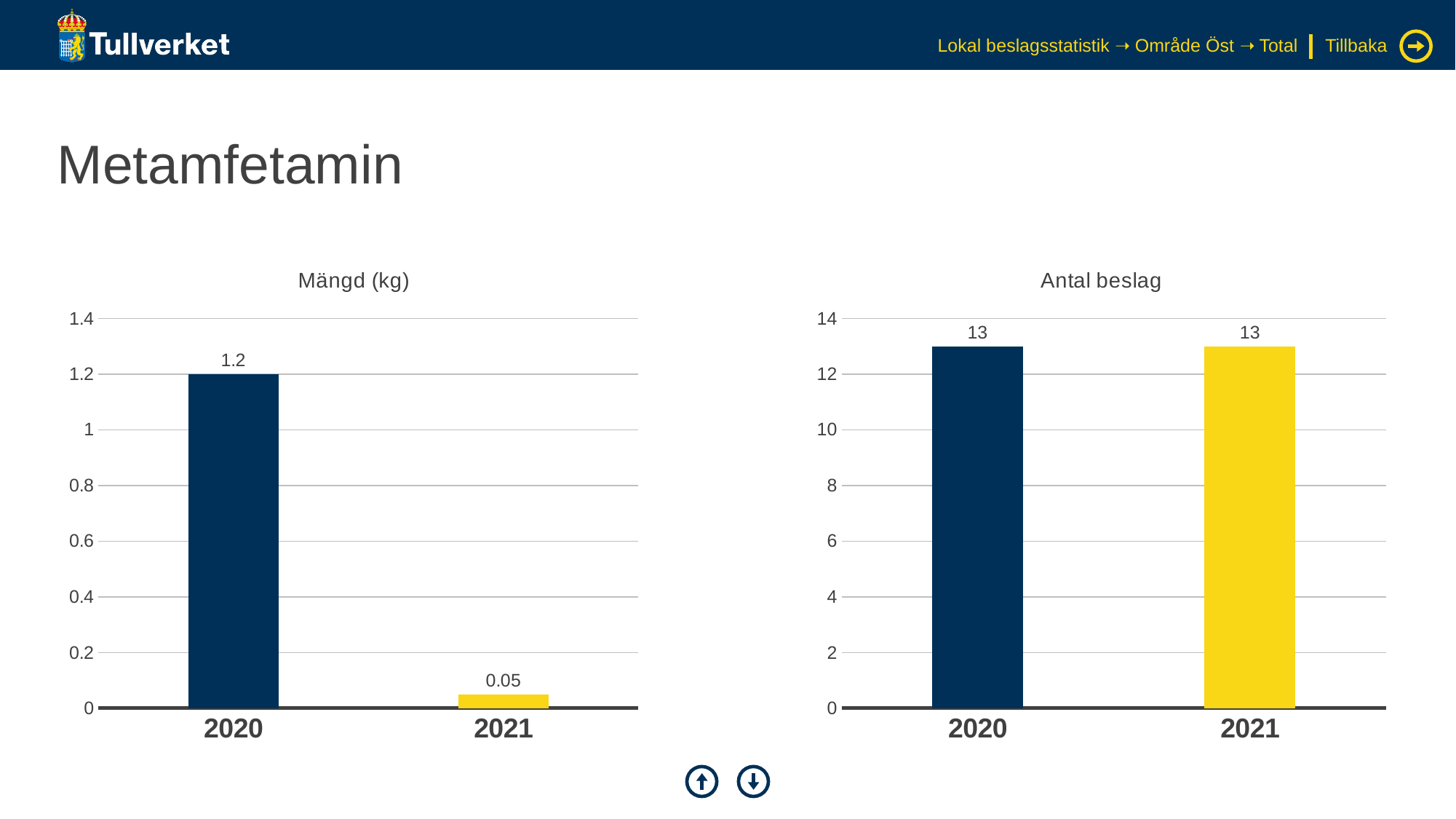
In the 'Mängd (kg)' chart, what is the difference between the 2020 and 2021 values? 1.15 In the 'Mängd (kg)' chart, what is the value for 2020? 1.2 In the 'Mängd (kg)' chart, which year has the lowest value? 2021 In the 'Antal beslag' chart, what is the difference between the 2020 and 2021 values? 0 In the 'Mängd (kg)' chart, is the value for 2020 greater or less than 1? greater In the 'Antal beslag' chart, what is the value for 2021? 13 In the 'Mängd (kg)' chart, do the values rise or fall from 2020 to 2021? fall In the 'Mängd (kg)' chart, which year has the highest value? 2020 In the 'Antal beslag' chart, how many years are shown on the x axis? 2 What kind of chart is the 'Mängd (kg)' chart? bar chart In the 'Mängd (kg)' chart, what is the value for 2021? 0.05 In the 'Antal beslag' chart, what is the value for 2020? 13